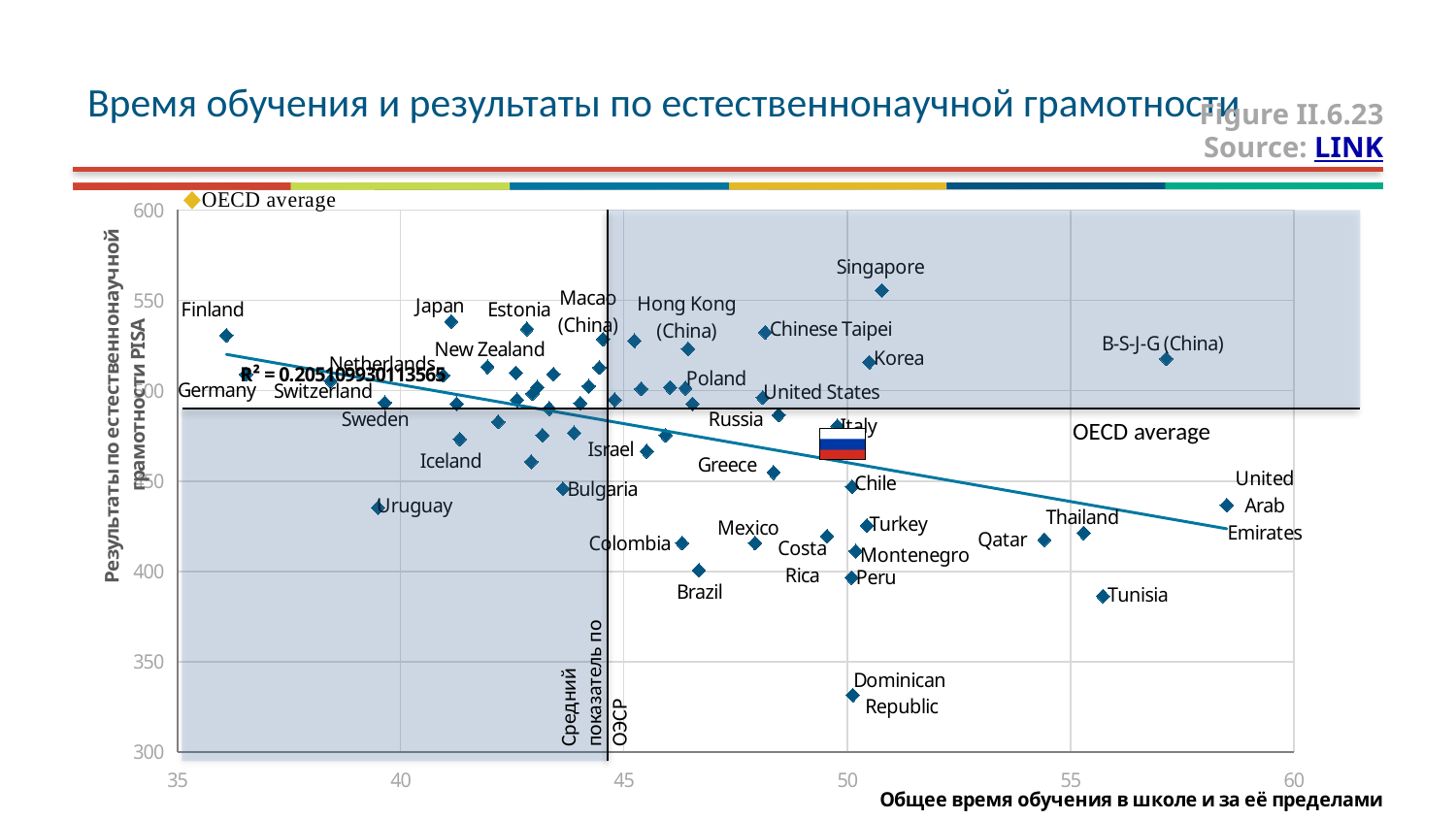
Which has a higher PISA science result, Japan or Mexico? Japan What R² value is printed on the chart? R² = 0.205109930113565 What kind of chart is shown on the slide? scatter chart Is the PISA science result for Tunisia greater or less than 400? less Is the total learning time for Finland greater or less than 40? less Which labelled country has the lowest PISA science result on the chart? Dominican Republic Does the fitted trend line rise or fall as total learning time increases? fall Is the PISA science result for Uruguay greater or less than 450? less Which has a higher PISA science result, Singapore or Korea? Singapore Which labelled country has the highest PISA science result on the chart? Singapore